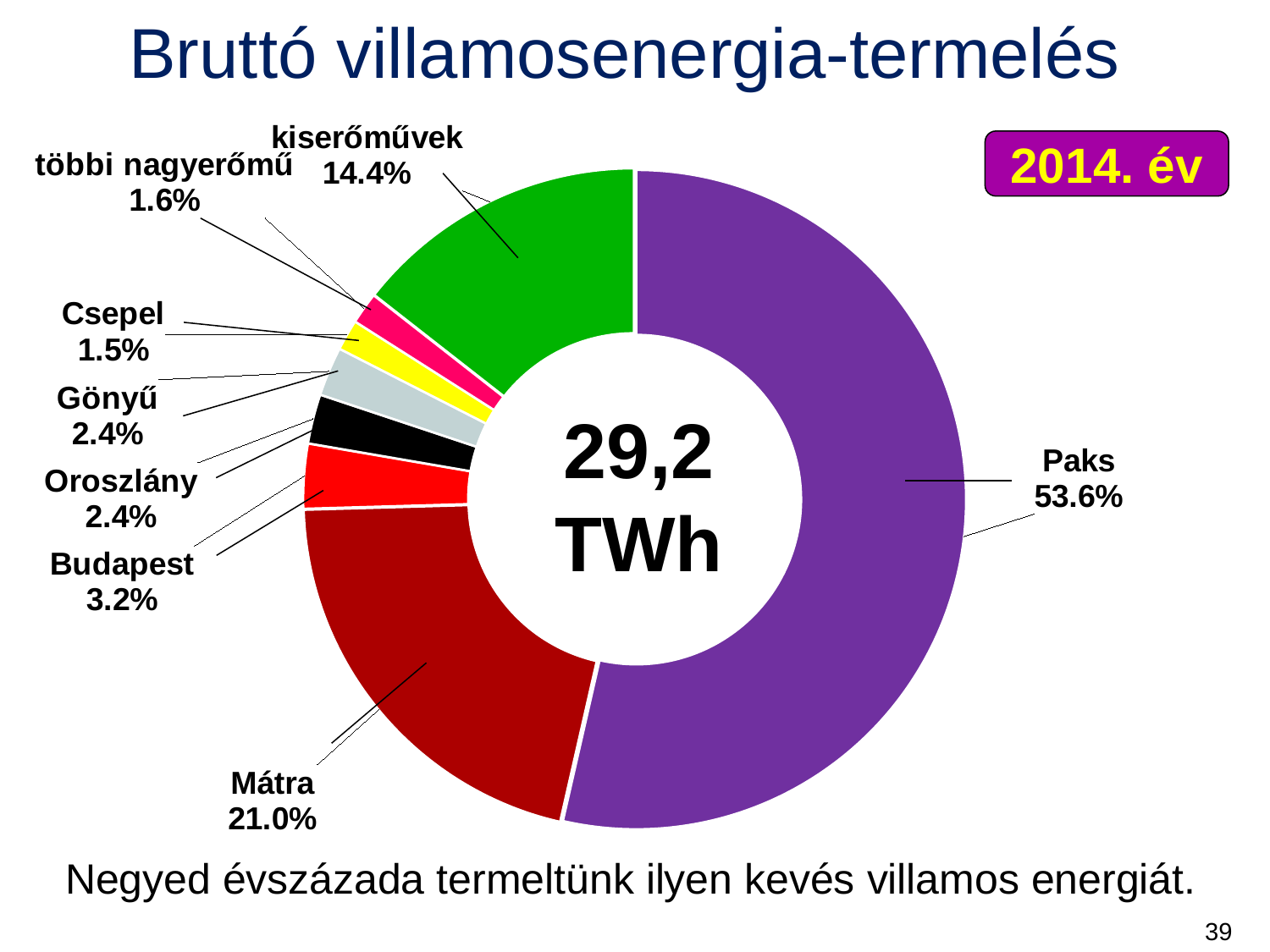
Which category has the largest share of the pie? Paks What is the difference in percentage points between Paks and Mátra? 32.6 What share is attributed to kiserőművek? 14.4% Which has a larger share, Budapest or Csepel? Budapest What share of gross electricity generation does Paks account for? 53.6% Which year does the chart refer to? 2014 What kind of chart is shown on the slide? Pie (doughnut) chart What percentage is shown for Mátra? 21.0% Which category has the smallest share of the pie? Csepel What percentage is shown for Budapest? 3.2% What total value is printed in the centre of the chart? 29,2 TWh How many slices does the chart have? 8